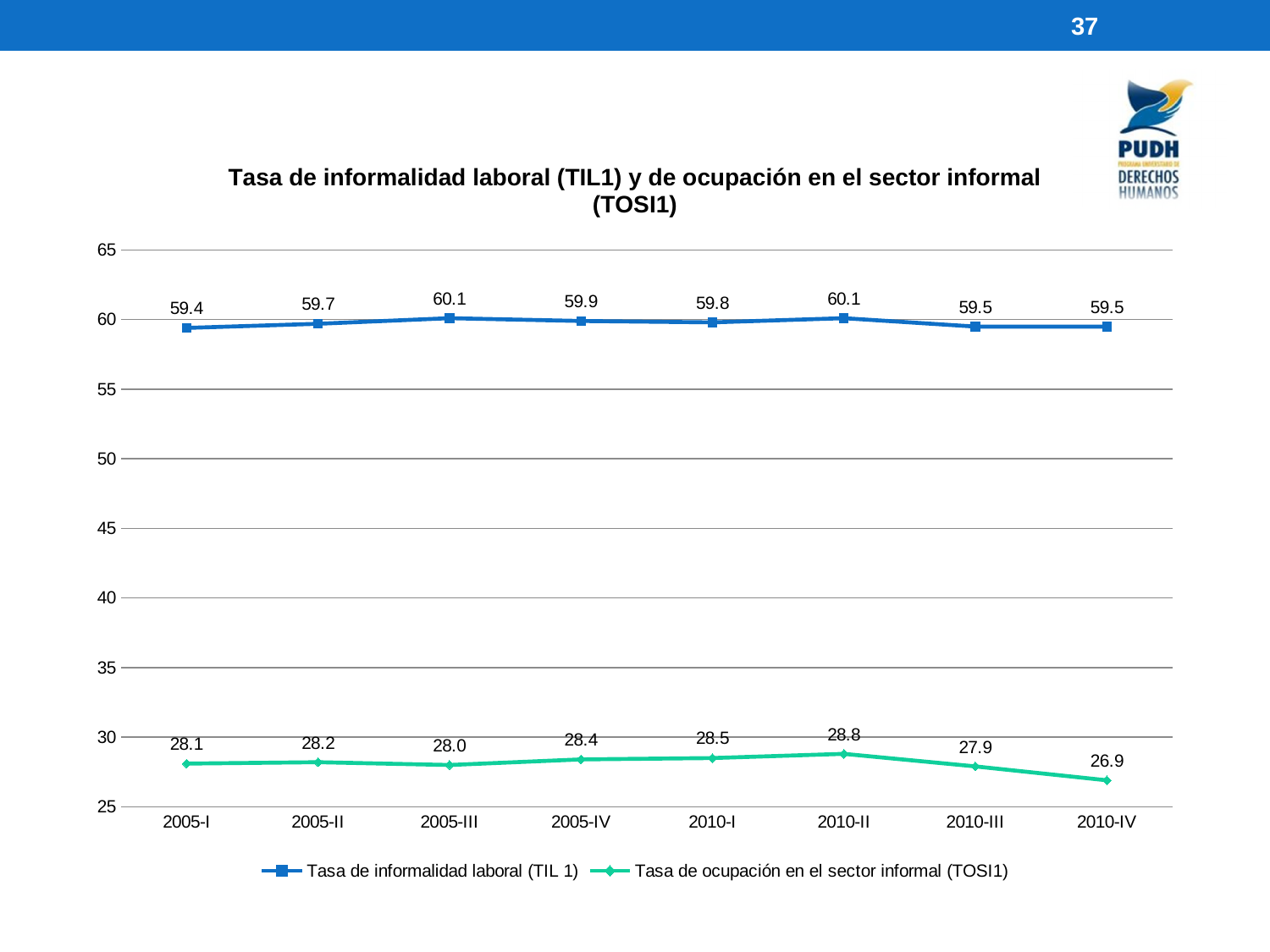
What is the difference between the TOSI1 values for 2010-II and 2010-IV? 1.9 In which period does Tasa de ocupación en el sector informal (TOSI1) reach its lowest value? 2010-IV Which is larger, the TIL 1 value for 2005-III or the TIL 1 value for 2005-I? 2005-III How many periods are shown on the x axis? 8 What kind of chart is shown on the slide? Line chart Does Tasa de ocupación en el sector informal (TOSI1) rise or fall from 2010-II to 2010-IV? Fall What is the value of Tasa de ocupación en el sector informal (TOSI1) for 2010-IV? 26.9 What is the difference between Tasa de informalidad laboral (TIL 1) and Tasa de ocupación en el sector informal (TOSI1) in 2005-I? 31.3 What is the value of Tasa de ocupación en el sector informal (TOSI1) for 2010-II? 28.8 How many series does the legend list? 2 What is the value of Tasa de informalidad laboral (TIL 1) for 2005-I? 59.4 In which period does Tasa de ocupación en el sector informal (TOSI1) reach its highest value? 2010-II